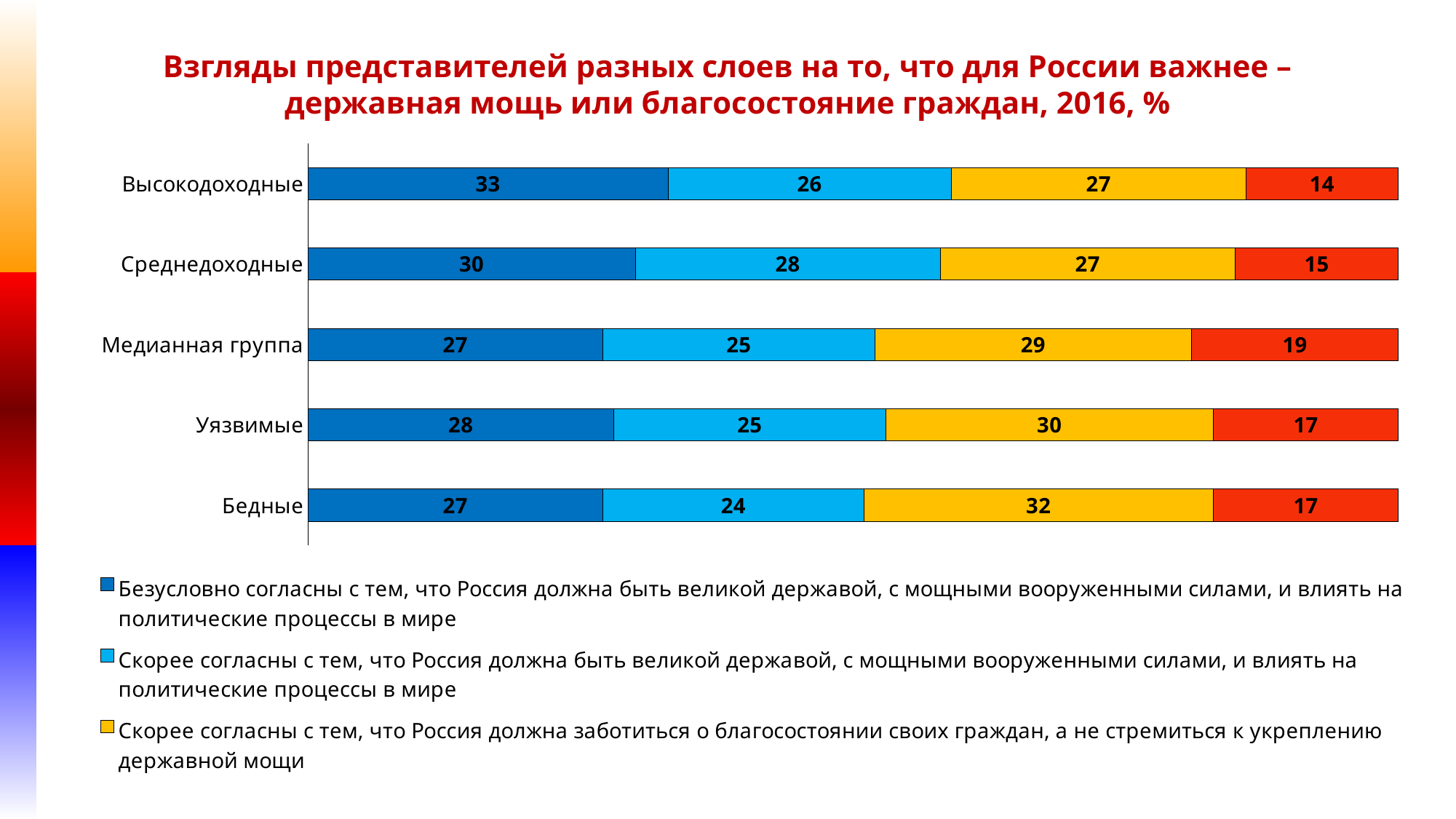
What is the total of all segments in the bar for Уязвимые? 100 What is the difference between the yellow segment values for Бедные and Высокодоходные? 5 What year is stated in the chart title? 2016 Which is larger: the dark blue segment for Среднедоходные or the dark blue segment for Уязвимые? Среднедоходные How many income groups (categories) are shown on the chart? 5 What is the value of the dark blue segment (Безусловно согласны, что Россия должна быть великой державой) for Высокодоходные? 33 What is the value of the red (last) segment for Медианная группа? 19 What is the value of the light blue segment (Скорее согласны, что Россия должна быть великой державой) for Среднедоходные? 28 Which group has the lowest value in the red (last) segment? Высокодоходные Which group has the highest value in the dark blue segment (Безусловно согласны, что Россия должна быть великой державой)? Высокодоходные What is the value of the yellow segment (Скорее согласны, что Россия должна заботиться о благосостоянии граждан) for Бедные? 32 What type of chart is shown on the slide? Stacked bar chart